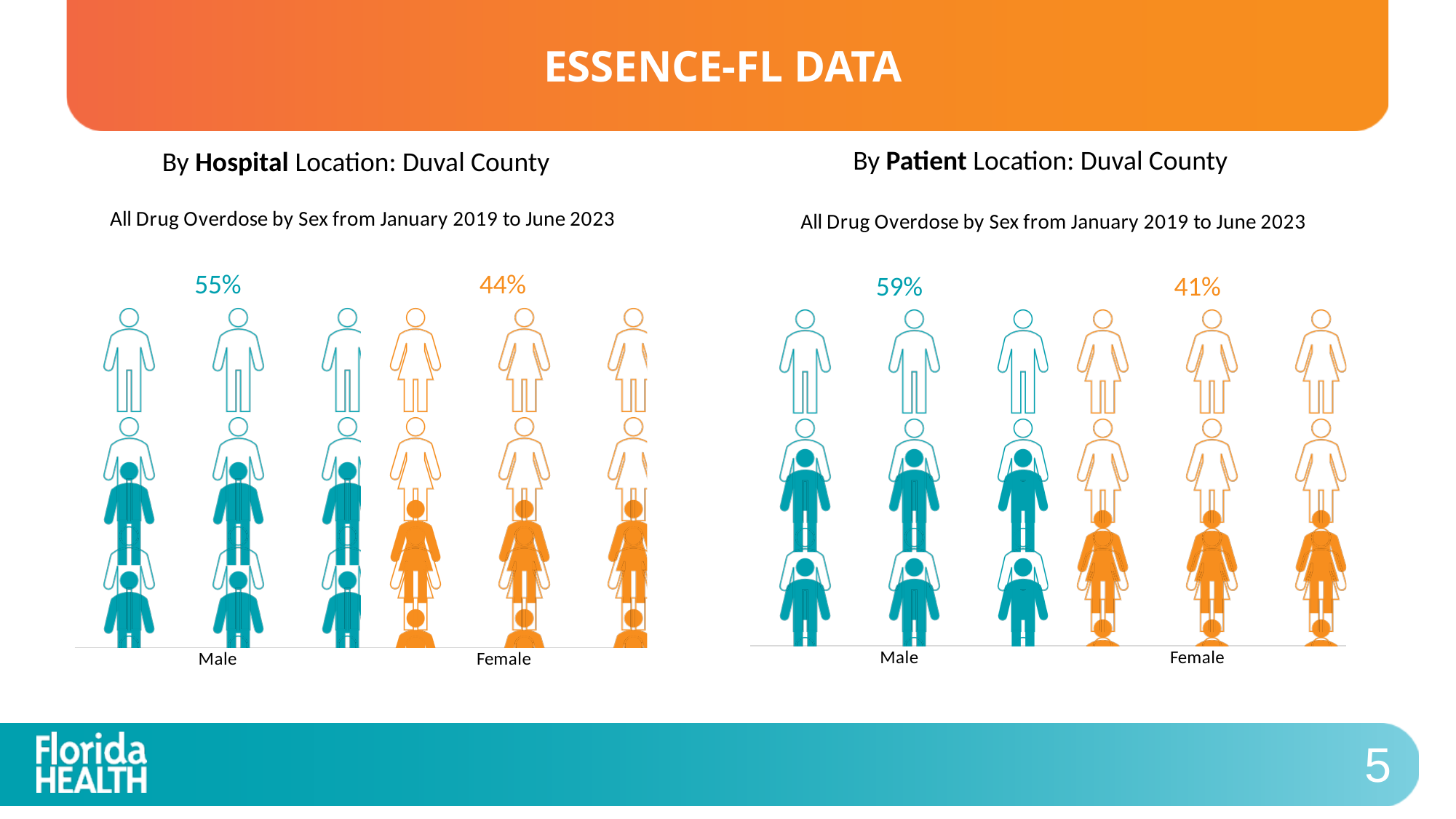
How many categories are shown in the 'By Hospital Location: Duval County' chart? 2 What kind of chart is used on the left side of the slide for 'By Hospital Location: Duval County'? Pictograph (icon chart) What is the subtitle shown above the 'By Patient Location: Duval County' chart? All Drug Overdose by Sex from January 2019 to June 2023 In the 'By Hospital Location: Duval County' chart, what percentage is shown for Male? 55% In the 'By Patient Location: Duval County' chart, what percentage is shown for Female? 41% In the 'By Patient Location: Duval County' chart, which category has the lower percentage? Female In the 'By Patient Location: Duval County' chart, what is the difference between the Male and Female percentages? 18% In the 'By Hospital Location: Duval County' chart, which category has the higher percentage? Male In the 'By Hospital Location: Duval County' chart, what percentage is shown for Female? 44% Is the Male percentage larger in the 'By Hospital Location' chart or the 'By Patient Location' chart? By Patient Location In the 'By Patient Location: Duval County' chart, what percentage is shown for Male? 59% In the 'By Hospital Location: Duval County' chart, what is the difference between the Male and Female percentages? 11%